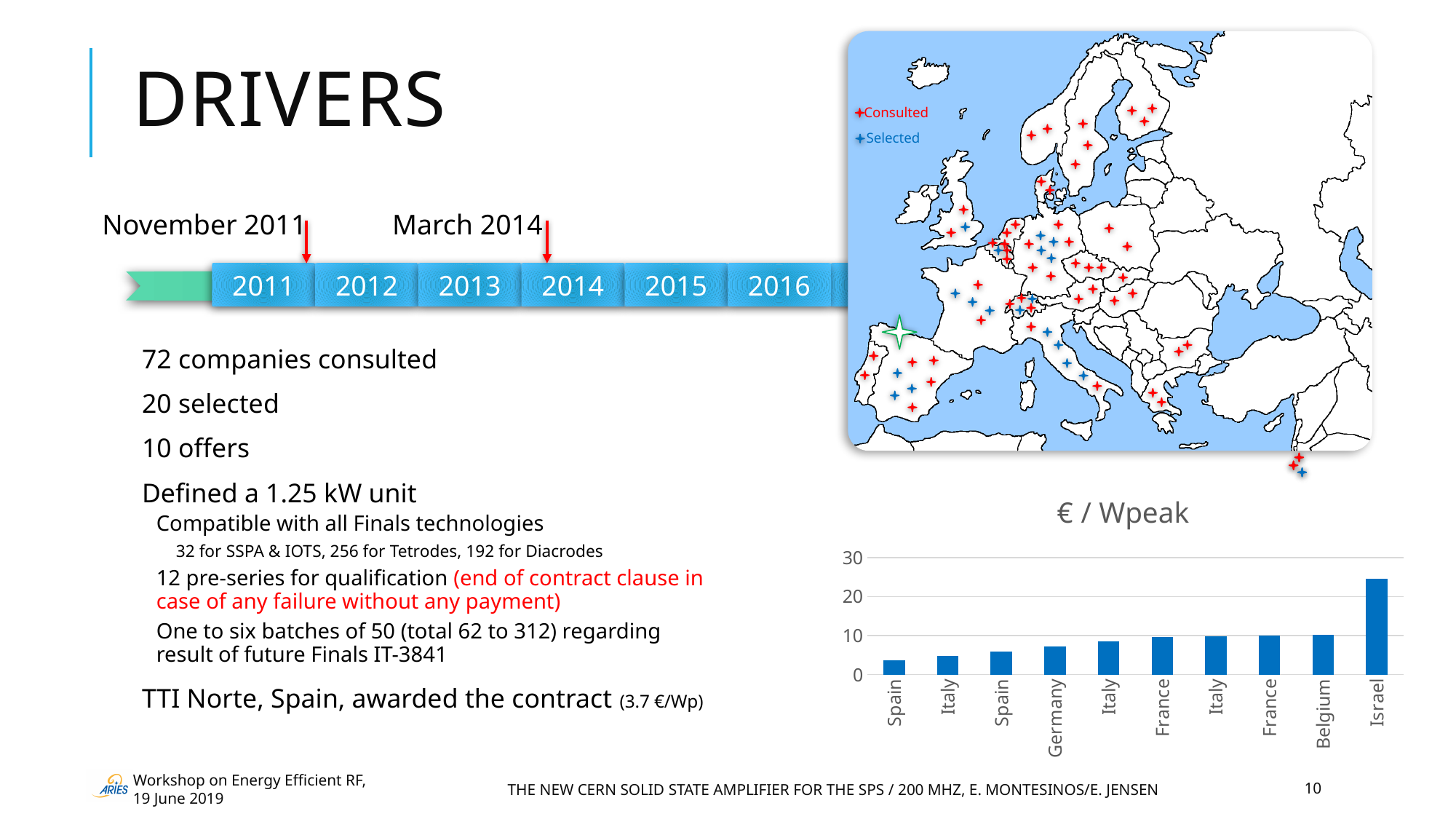
In the "€ / Wpeak" chart, is the value for the leftmost Spain bar greater or less than 10? less In the "€ / Wpeak" chart, do the bar values rise or fall from left to right? rise What is the highest tick value shown on the vertical axis of the "€ / Wpeak" chart? 30 In the "€ / Wpeak" chart, which is larger: the value for Germany or the value for the leftmost Spain bar? Germany What is the title of the bar chart on the slide? € / Wpeak How many bars are plotted in the "€ / Wpeak" chart? 10 What kind of chart is the "€ / Wpeak" chart? bar chart In the "€ / Wpeak" chart, which is larger: the value for Israel or the value for Belgium? Israel In the "€ / Wpeak" chart, is the value for Germany greater or less than 10? less In the "€ / Wpeak" chart, which category has the highest value? Israel In the "€ / Wpeak" chart, which bar is the lowest? the first Spain bar (leftmost) In the "€ / Wpeak" chart, is the value for Israel greater or less than 20? greater